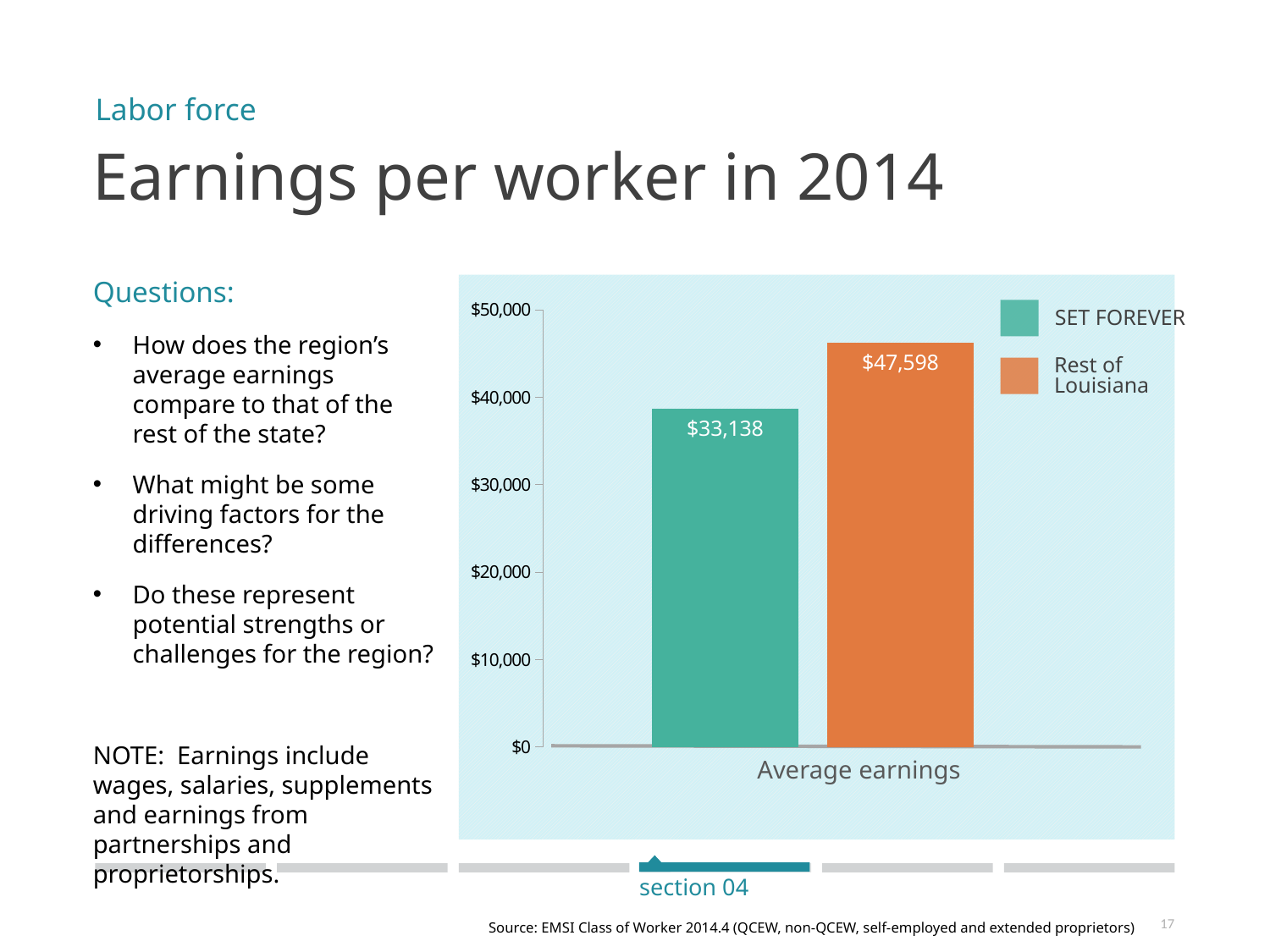
Is the value for Rest of Louisiana greater or less than $50,000? less What is the average earnings value for SET FOREVER? $33,138 What is the difference between the average earnings of Rest of Louisiana and SET FOREVER? $14,460 What colour is the bar for Rest of Louisiana? orange How many series does the legend list? 2 What is the label on the x axis category of the chart? Average earnings What kind of chart is shown on the slide? bar chart Is the value for SET FOREVER greater or less than $30,000? greater What is the average earnings value for Rest of Louisiana? $47,598 Which series has the higher average earnings? Rest of Louisiana Is the average earnings value for SET FOREVER larger or smaller than that for Rest of Louisiana? smaller Which series has the lower average earnings? SET FOREVER